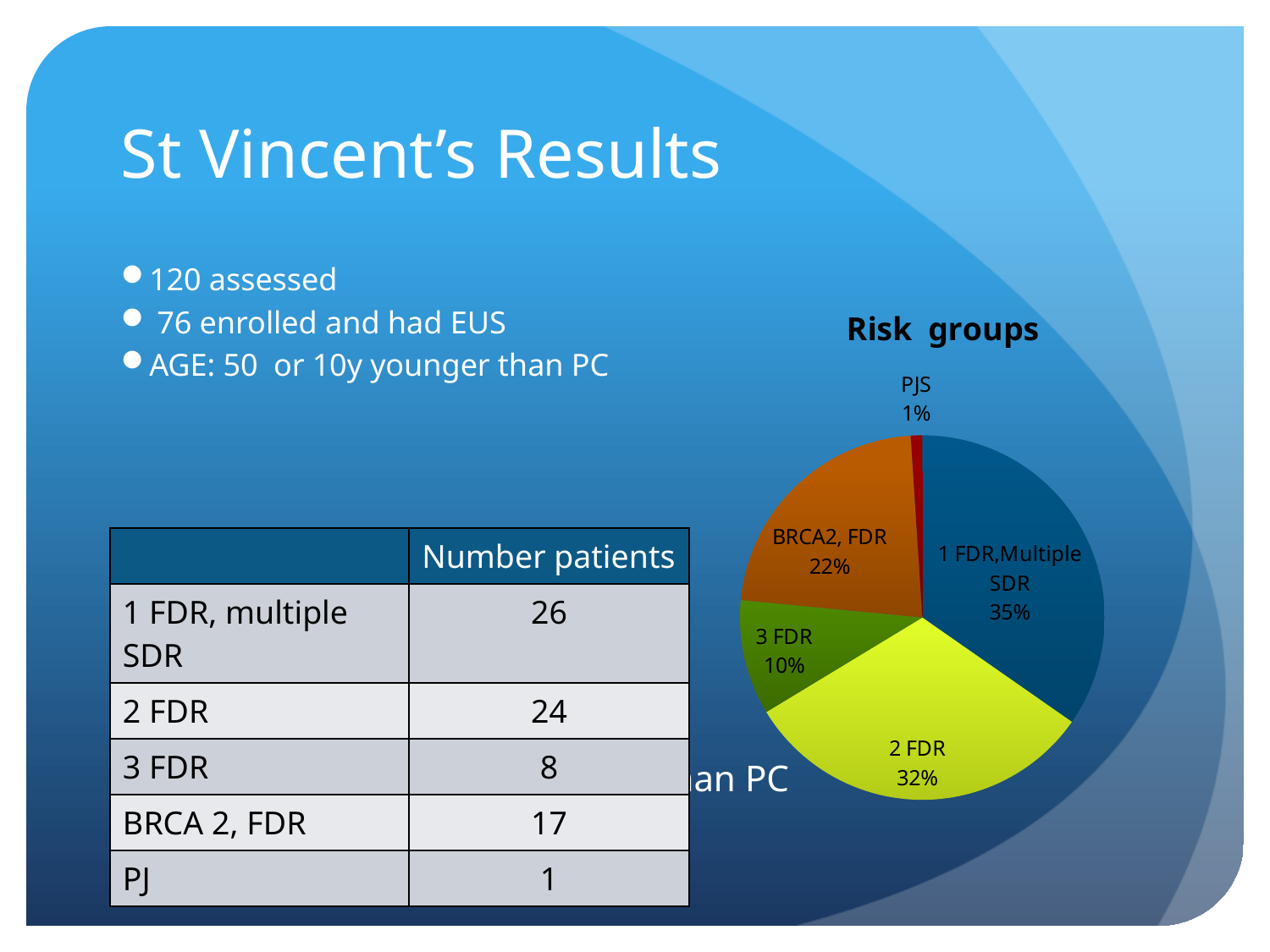
What is the difference in percentage points between the "BRCA2, FDR" slice and the "3 FDR" slice? 12% How many slices does the pie chart have? 5 What share of the pie does the "BRCA2, FDR" slice represent? 22% Which slice is larger, "2 FDR" or "BRCA2, FDR"? 2 FDR What share of the pie does the "2 FDR" slice represent? 32% What share of the pie does the "1 FDR,Multiple SDR" slice represent? 35% What kind of chart is the "Risk groups" chart? pie chart Which slice of the pie chart is the smallest? PJS Which slice of the pie chart is the largest? 1 FDR,Multiple SDR What is the title of the pie chart? Risk groups